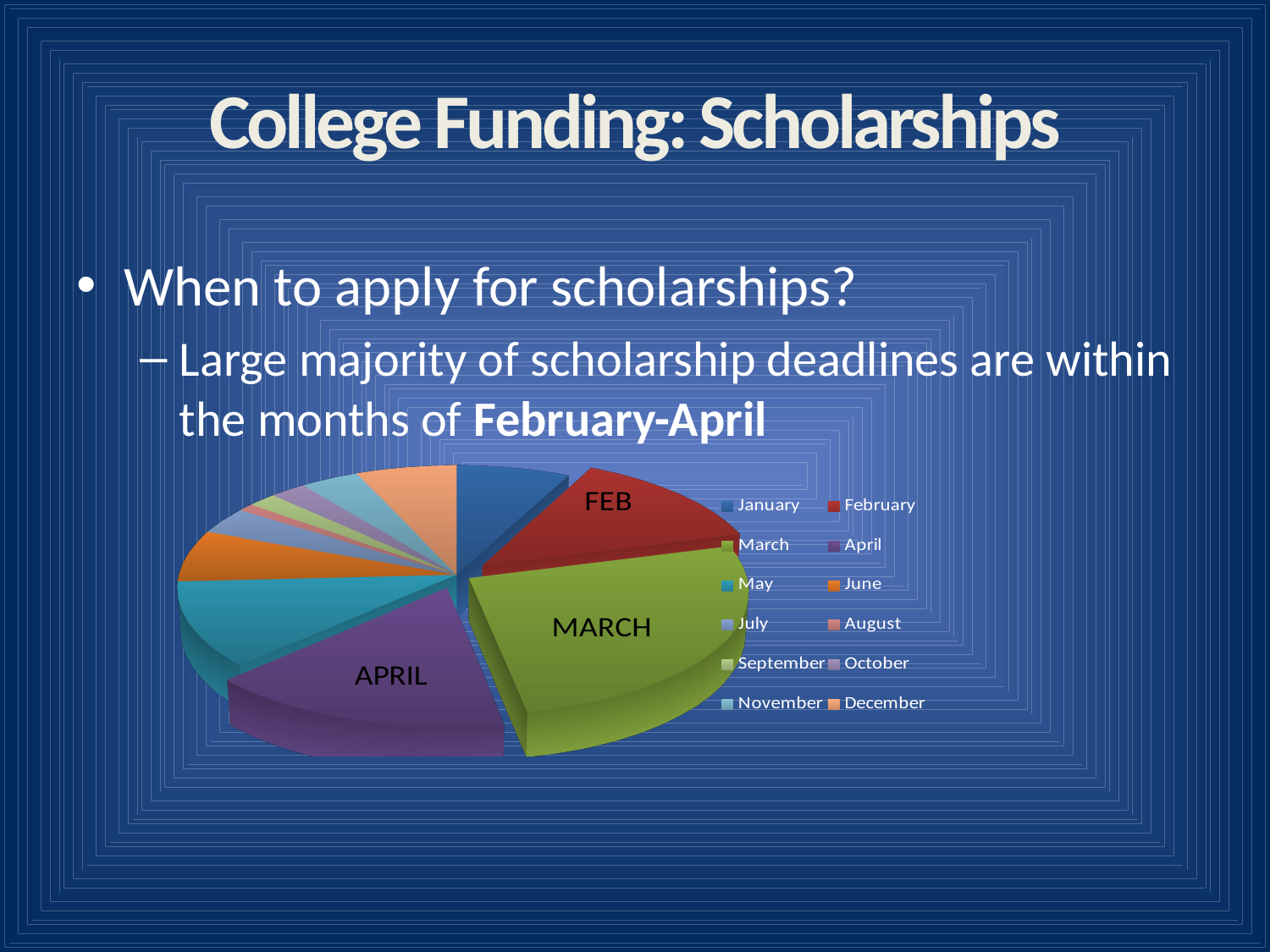
Which three slices of the pie chart are labelled directly on the chart? FEB, MARCH, APRIL What kind of chart is shown on the slide? pie chart Which slice is larger in the pie chart, February or July? February Which month has the largest slice in the pie chart? March How many categories does the pie chart's legend list? 12 Which slice is larger in the pie chart, April or June? April What colour is the March slice in the pie chart? green Which slice is larger in the pie chart, March or January? March